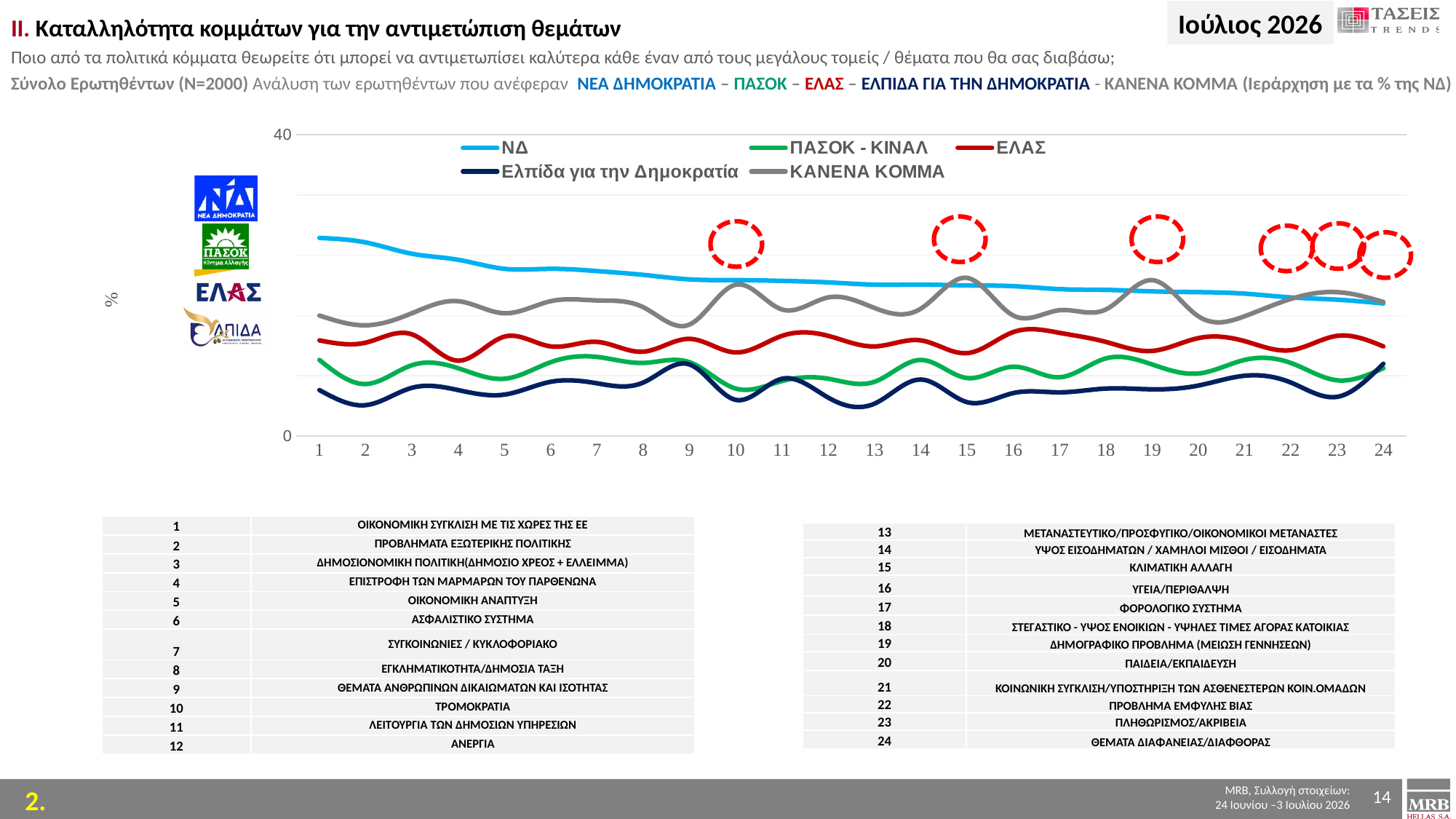
How many series does the chart legend list? 5 Which series has the lowest value at point 1 on the chart? Ελπίδα για την Δημοκρατία At point 15, which is larger: the value for ΚΑΝΕΝΑ ΚΟΜΜΑ or the value for ΕΛΑΣ? ΚΑΝΕΝΑ ΚΟΜΜΑ How many points are there along the x axis of the chart? 24 Is the value for ΝΔ at point 1 greater or less than 40? less What is the maximum value shown on the chart's y axis? 40 At point 5, which is larger: the value for ΝΔ or the value for ΠΑΣΟΚ - ΚΙΝΑΛ? ΝΔ At point 1, which is larger: the value for ΠΑΣΟΚ - ΚΙΝΑΛ or the value for Ελπίδα για την Δημοκρατία? ΠΑΣΟΚ - ΚΙΝΑΛ What kind of chart is shown on the slide? line chart What colour is the ΝΔ line in the chart legend? light blue Does the ΝΔ line generally rise or fall from point 1 to point 24? fall Which series has the highest value at point 1 on the chart? ΝΔ